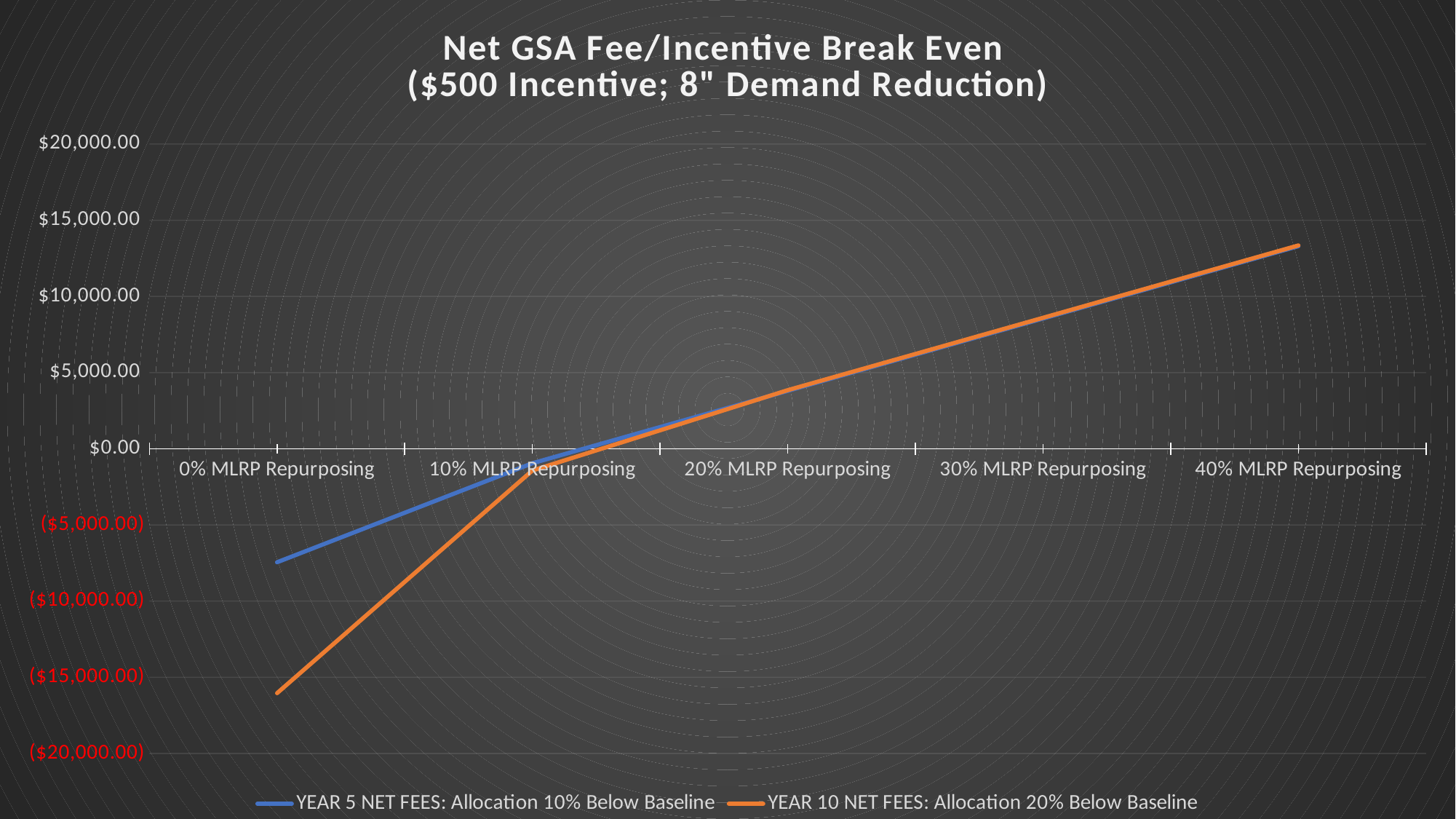
How many series does the legend list? 2 At which category does the YEAR 10 NET FEES series reach its highest value? 40% MLRP Repurposing At 40% MLRP Repurposing, is the value for YEAR 10 NET FEES greater or less than $15,000.00? less At 0% MLRP Repurposing, is the value for YEAR 5 NET FEES greater or less than ($10,000.00)? greater At 40% MLRP Repurposing, is the value for YEAR 10 NET FEES greater or less than $10,000.00? greater How many MLRP Repurposing categories are shown on the x axis? 5 What kind of chart is shown on the slide? line chart At 0% MLRP Repurposing, which series has the higher value, YEAR 5 NET FEES or YEAR 10 NET FEES? YEAR 5 NET FEES At which category does the YEAR 10 NET FEES series have its lowest value? 0% MLRP Repurposing What is the title of the chart? Net GSA Fee/Incentive Break Even ($500 Incentive; 8" Demand Reduction) Do the values for YEAR 10 NET FEES rise or fall as MLRP Repurposing increases along the x axis? rise